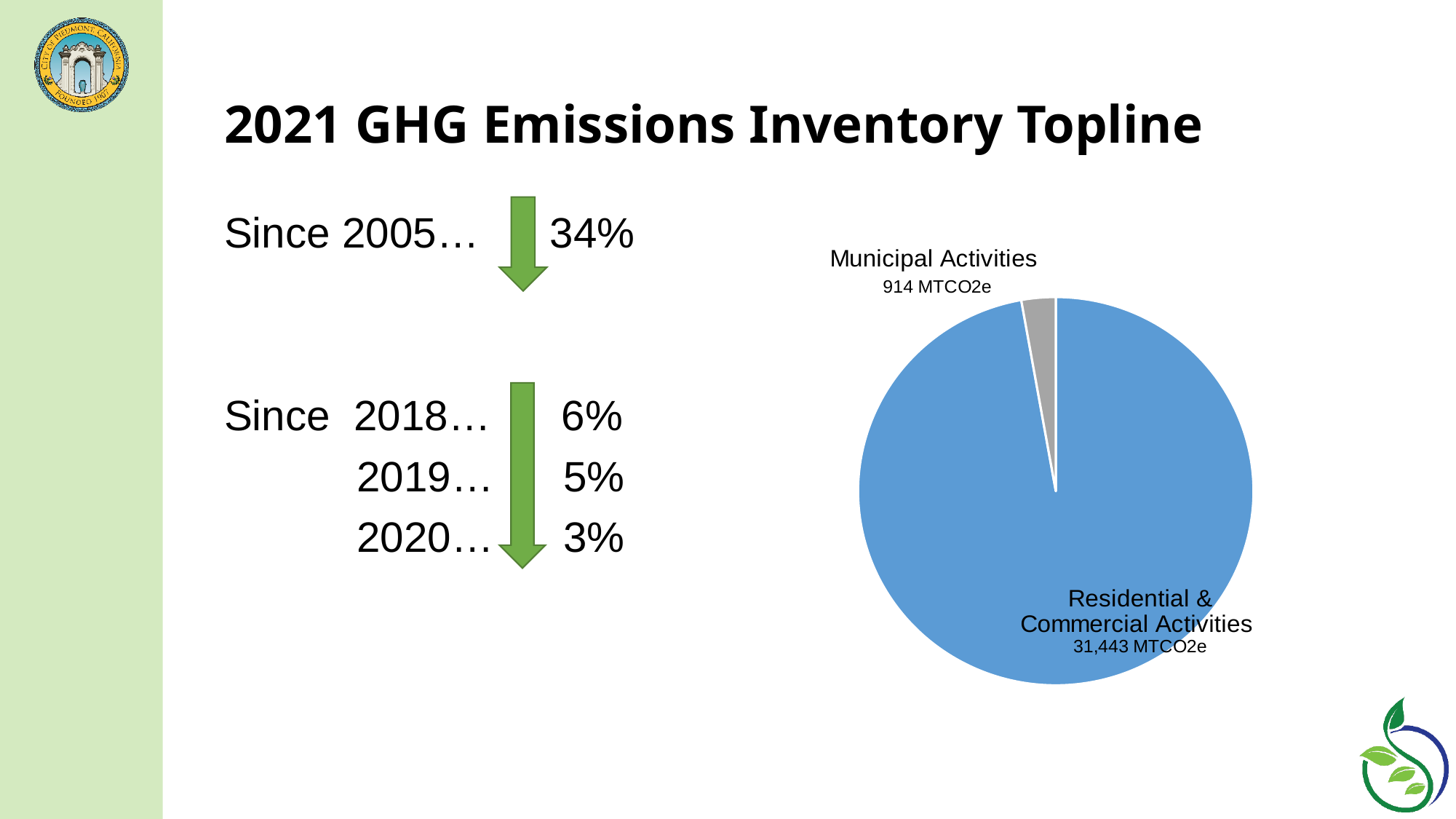
What is the difference between Residential & Commercial Activities and Municipal Activities in the pie chart? 30,529 MTCO2e What is the total of the two slices in the pie chart? 32,357 MTCO2e Which slice of the pie chart is the largest? Residential & Commercial Activities Which slice of the pie chart is the smallest? Municipal Activities What colour is the Residential & Commercial Activities slice in the pie chart? Blue Which is larger in the pie chart, Municipal Activities or Residential & Commercial Activities? Residential & Commercial Activities What is the value for Residential & Commercial Activities in the pie chart? 31,443 MTCO2e What kind of chart is shown on the slide? Pie chart How many slices does the pie chart have? 2 What is the value for Municipal Activities in the pie chart? 914 MTCO2e What colour is the Municipal Activities slice in the pie chart? Grey